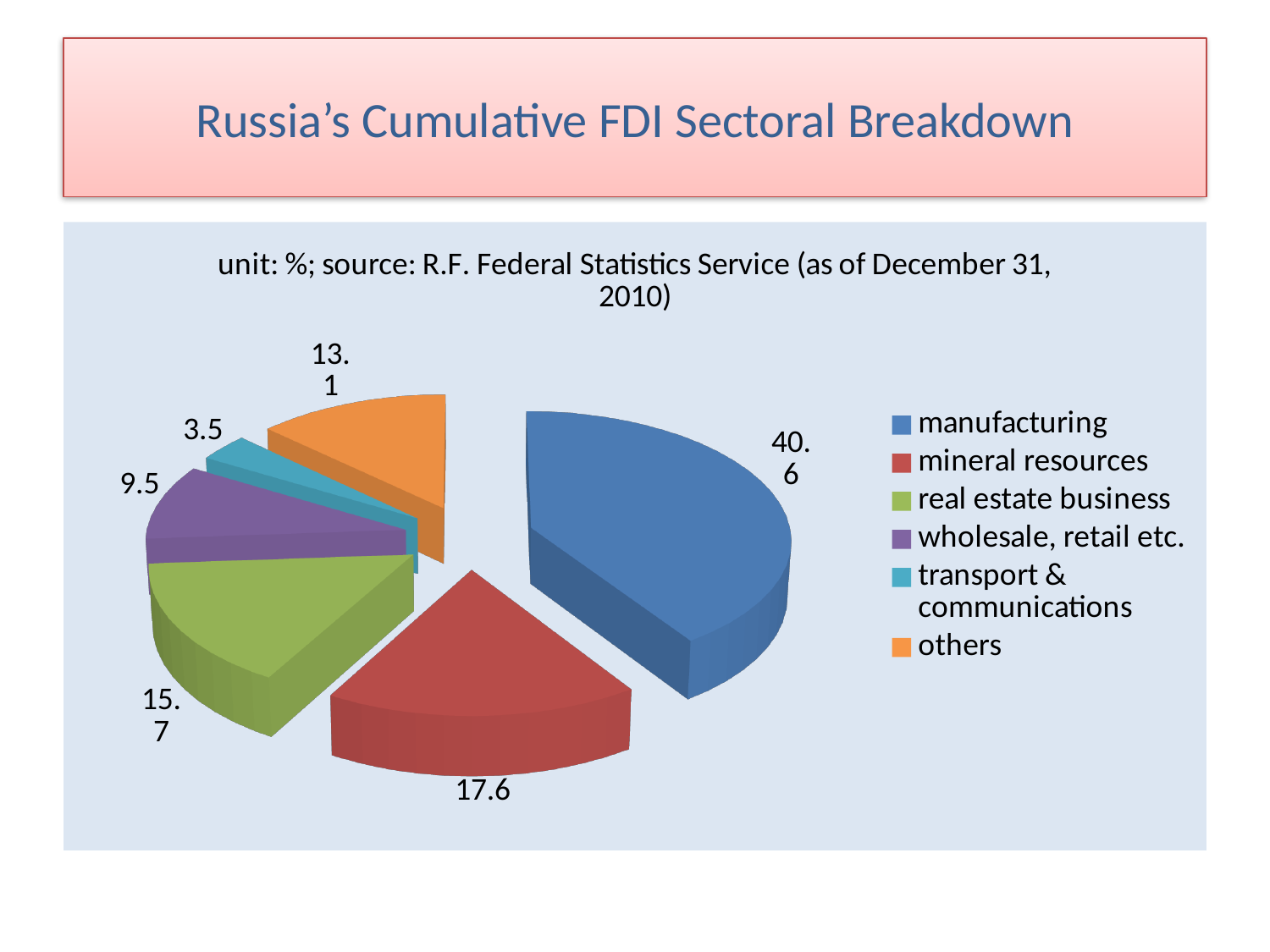
Which is larger, the value for wholesale, retail etc. or the value for others? others Which sector has the largest share of the pie? manufacturing What is the value for real estate business? 15.7 What unit are the values in, according to the chart title? % What is the value for manufacturing? 40.6 How many sectors are shown in the pie chart? 6 What is the value for transport & communications? 3.5 What is the value for mineral resources? 17.6 What kind of chart is shown on the slide? pie chart Which sector has the smallest share of the pie? transport & communications What is the value for others? 13.1 What is the difference between the values for manufacturing and mineral resources? 23